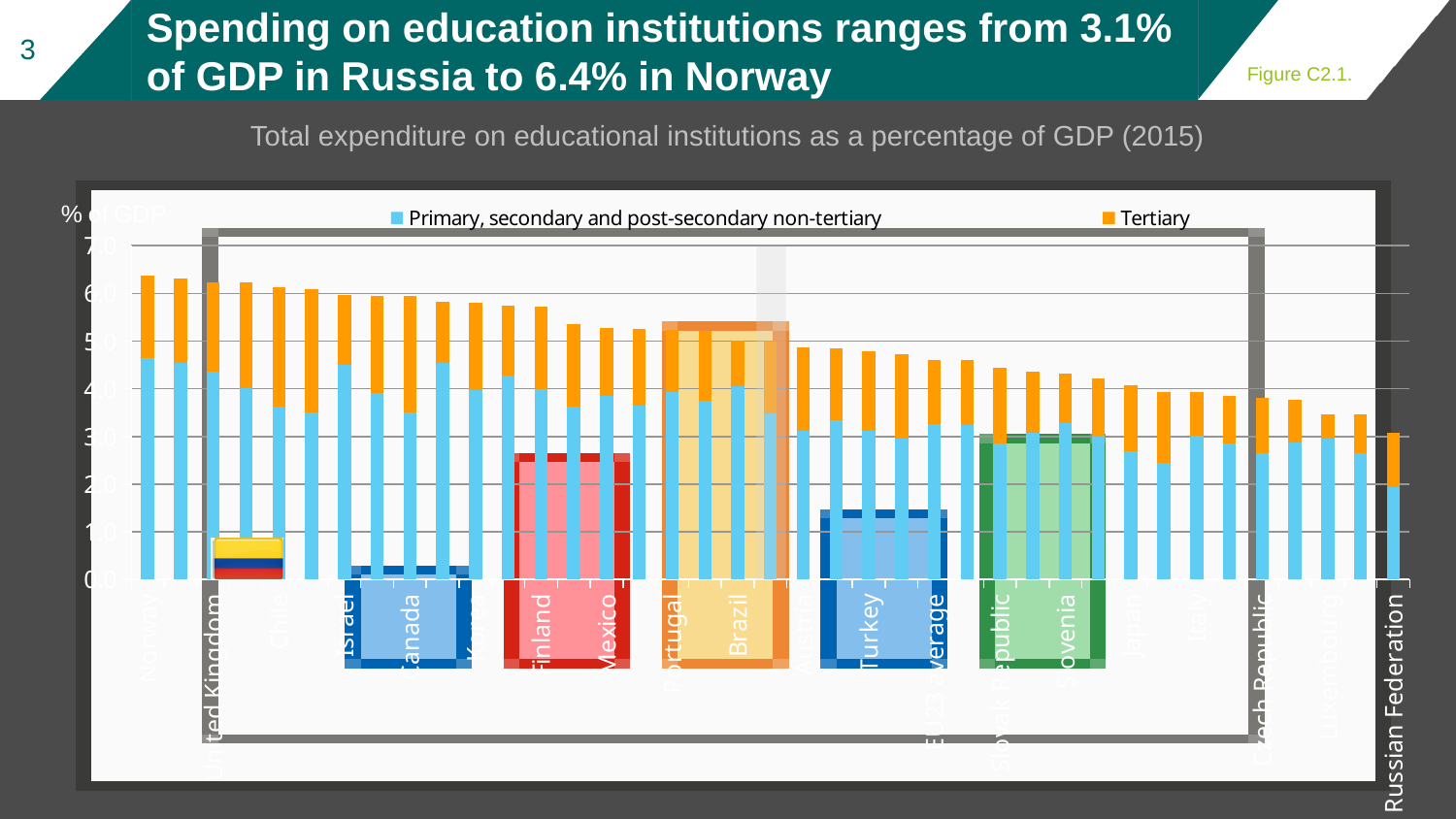
Do the total bar heights rise or fall moving from left to right along the x axis? Fall According to the slide, what is Norway's total spending on education institutions as a percentage of GDP? 6.4% How many series does the legend list? 2 What kind of chart is shown on the slide? Stacked bar chart Is the total value for Luxembourg greater or less than 4.0? less Which country has the lowest total expenditure on educational institutions as a percentage of GDP? Russian Federation Is the total value for Finland greater or less than 5.0? greater What is the difference between Norway's and Russia's spending on education institutions as a percentage of GDP? 3.3% Which has a larger total expenditure as a percentage of GDP, Turkey or the Russian Federation? Turkey Which country has the highest total expenditure on educational institutions as a percentage of GDP? Norway According to the slide, what is Russia's total spending on education institutions as a percentage of GDP? 3.1% Which series is shown in orange in the legend? Tertiary